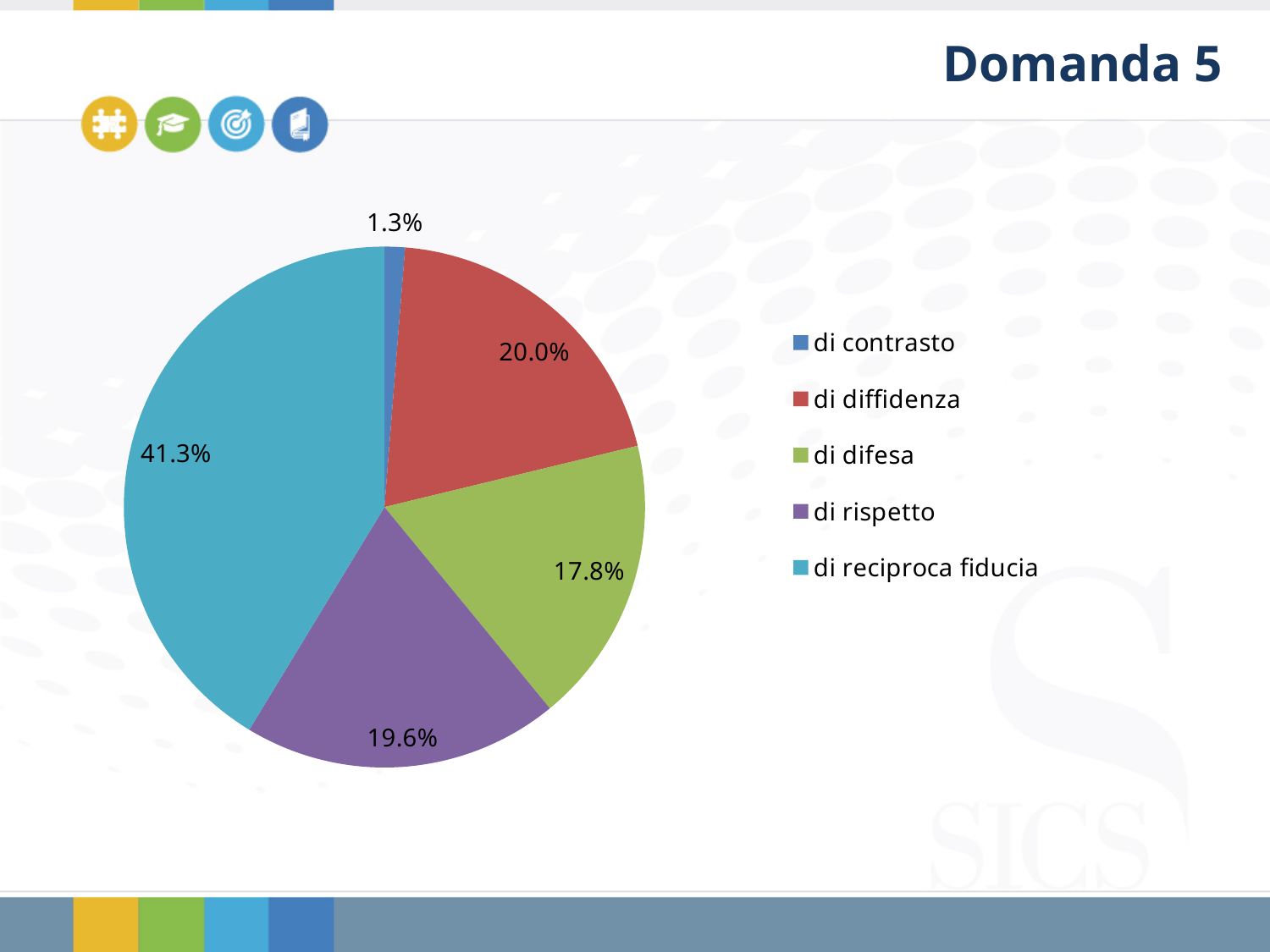
What is the title of the slide containing the chart? Domanda 5 How many categories does the legend list? 5 What is the share for "di diffidenza"? 20.0% What is the share for "di contrasto"? 1.3% What is the share for "di difesa"? 17.8% Which category has the largest slice of the pie? di reciproca fiducia What is the share for "di reciproca fiducia"? 41.3% Which category has the smallest slice of the pie? di contrasto What is the difference in percentage points between "di reciproca fiducia" and "di diffidenza"? 21.3 Which is larger, the slice for "di diffidenza" or the slice for "di difesa"? di diffidenza What kind of chart is shown on the slide? pie chart What is the share for "di rispetto"? 19.6%